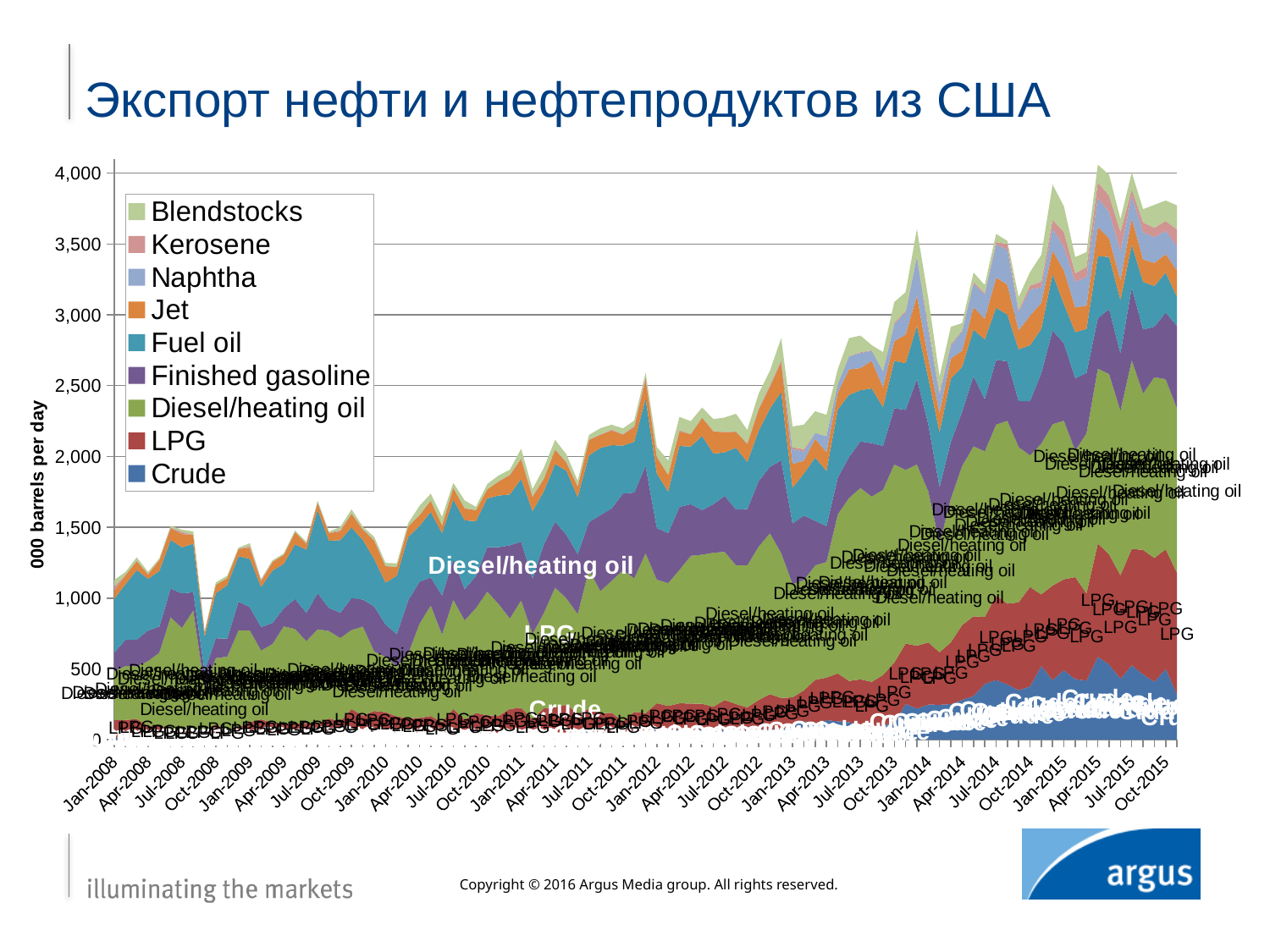
Does the total stacked value generally rise or fall from Jan-2008 to Oct-2015? Rise Is the total stacked value in Jan-2008 greater or less than 1,000? greater Is the total stacked value in Oct-2015 greater or less than 3,500? greater How many series does the legend list? 9 What is the highest tick value shown on the vertical axis? 4,000 Which series forms the bottom layer of the stacked area? Crude Which series has the largest band in 2015, Diesel/heating oil or Kerosene? Diesel/heating oil What kind of chart is shown on the slide? Stacked area chart Which series is listed first (at the top) in the legend? Blendstocks What is the title of the slide? Экспорт нефти и нефтепродуктов из США Is the total stacked value in Oct-2008 greater or less than 1,000? greater What is the label on the vertical axis? 000 barrels per day